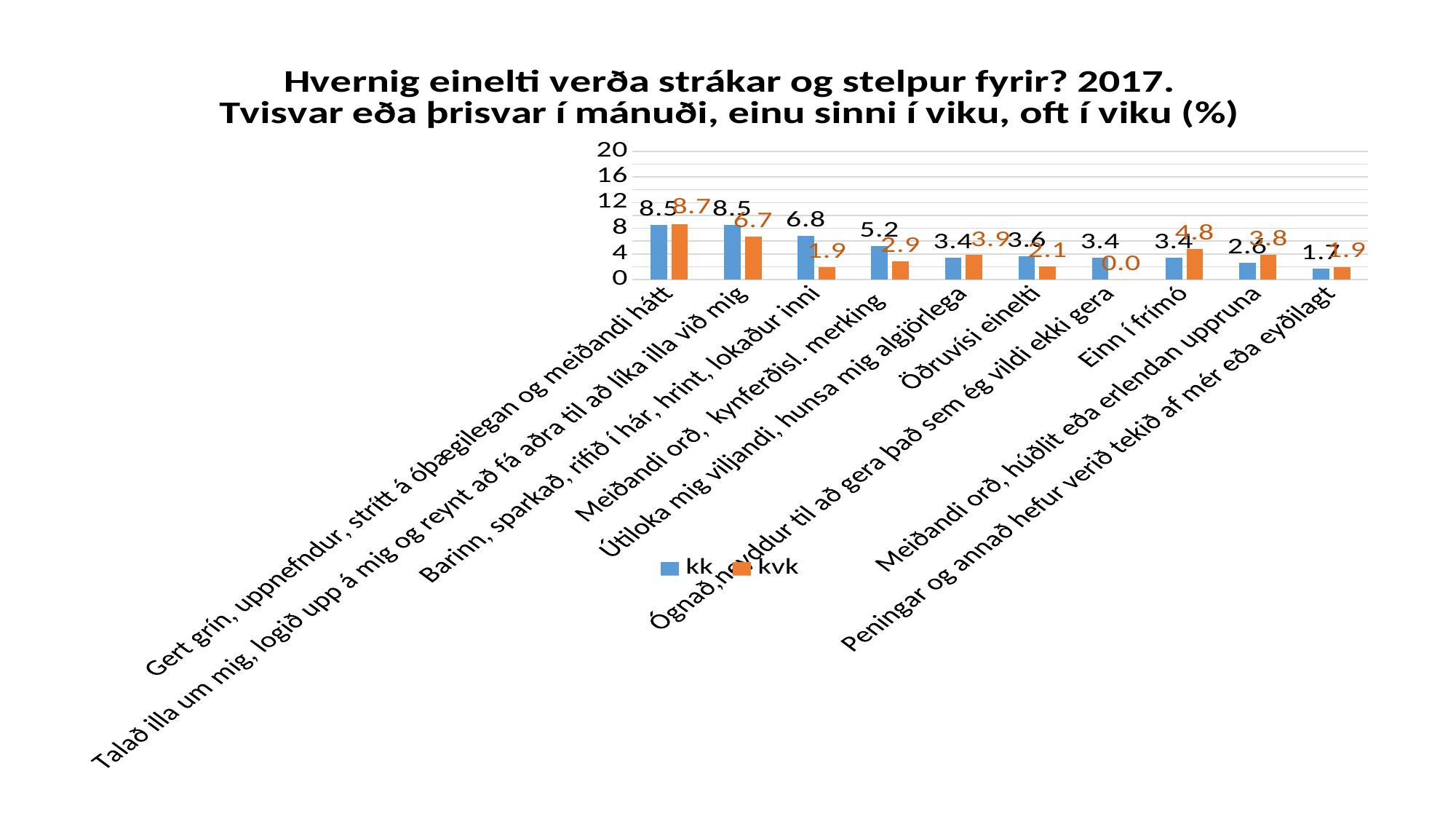
How many categories are shown on the x axis? 10 What is the kk value for "Barinn, sparkað, rifið í hár, hrint, lokaður inni"? 6.8 How many series does the legend list? 2 For "Öðruvísi einelti", which series has the larger value, kk or kvk? kk Which category has the lowest kk value? Peningar og annað hefur verið tekið af mér eða eyðilagt For "Meiðandi orð, húðlit eða erlendan uppruna", which series has the larger value, kk or kvk? kvk What is the difference between the kk and kvk values for "Meiðandi orð, kynferðisl. merking"? 2.3 What is the kvk value for "Ógnað, neyddur til að gera það sem ég vildi ekki gera"? 0.0 What type of chart is shown on the slide? Bar chart Which category has the highest kvk value? Gert grín, uppnefndur, strítt á óþægilegan og meiðandi hátt What is the kvk value for "Einn í frímó"? 4.8 What is the difference between the kk and kvk values for "Barinn, sparkað, rifið í hár, hrint, lokaður inni"? 4.9